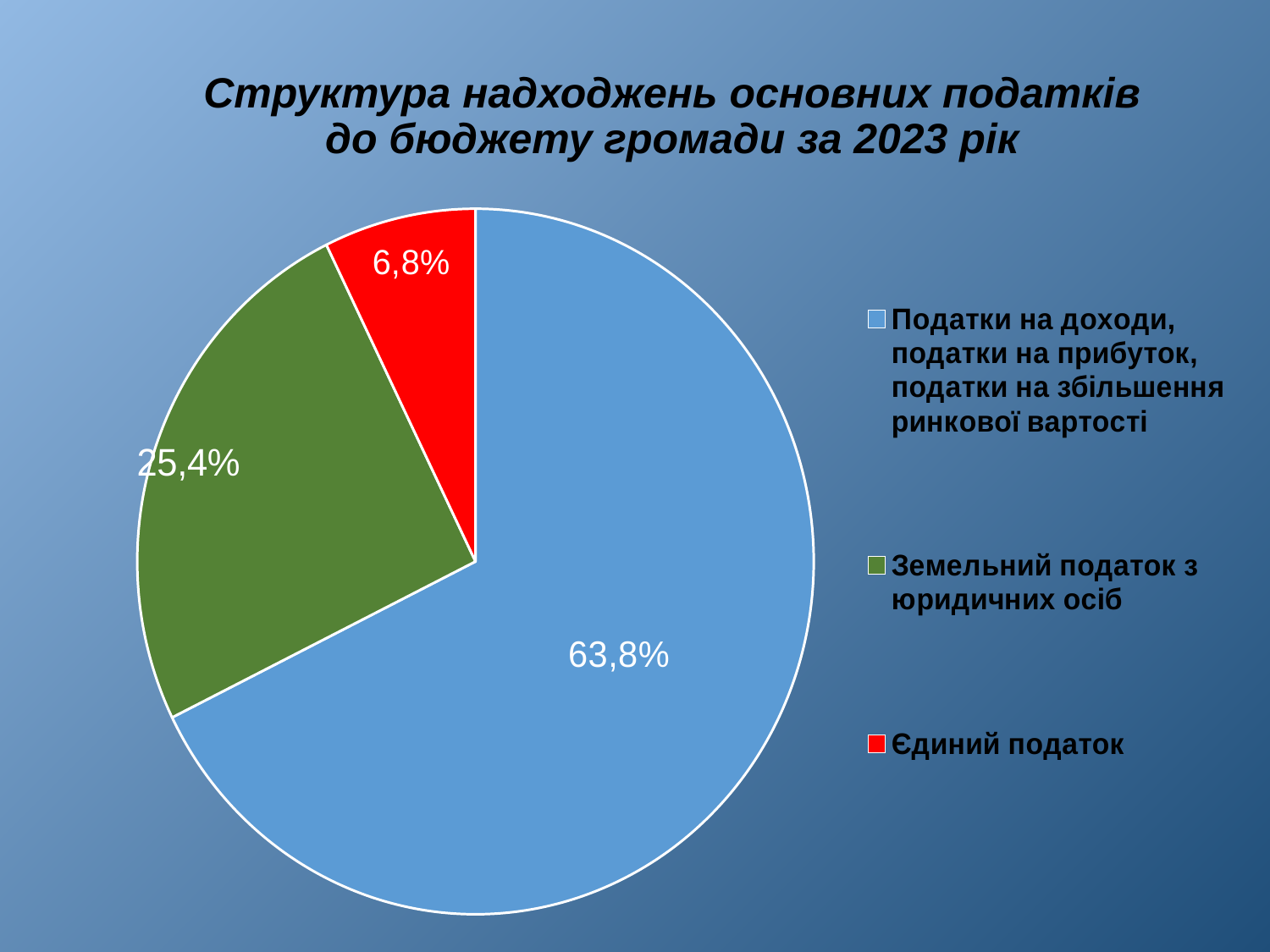
How many slices does the pie chart have? 3 What colour is the "Єдиний податок" slice? red Which is larger: the "Земельний податок з юридичних осіб" slice or the "Єдиний податок" slice? Земельний податок з юридичних осіб What kind of chart is shown on the slide? pie chart Which category has the smallest slice of the pie? Єдиний податок What is the title of the chart? Структура надходжень основних податків до бюджету громади за 2023 рік What is the difference in percentage points between the "Земельний податок з юридичних осіб" slice and the "Єдиний податок" slice? 18,6 What share of the pie does "Єдиний податок" have? 6,8% Which category has the largest slice of the pie? Податки на доходи, податки на прибуток, податки на збільшення ринкової вартості What is the value shown for "Податки на доходи, податки на прибуток, податки на збільшення ринкової вартості"? 63,8% What share of the pie does "Земельний податок з юридичних осіб" have? 25,4% How many entries does the legend list? 3